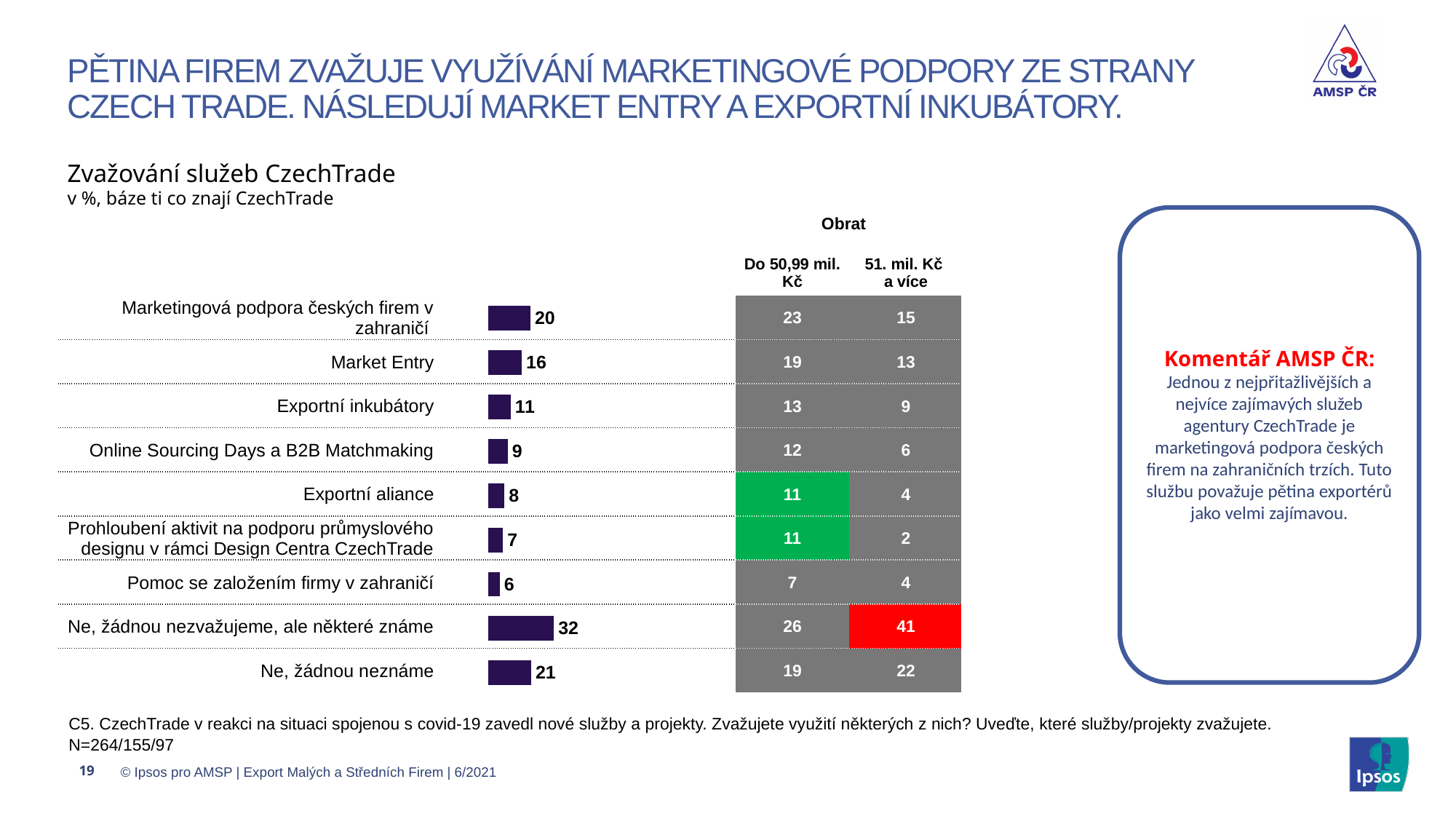
What is the value for "Exportní inkubátory" in the bar chart? 11 What is the value for "Pomoc se založením firmy v zahraničí" in the bar chart? 6 What type of chart is shown on the slide? bar chart What is the difference between the values for "Online Sourcing Days a B2B Matchmaking" and "Exportní aliance"? 1 Which is larger: the value for "Marketingová podpora českých firem v zahraničí" or the value for "Market Entry"? Marketingová podpora českých firem v zahraničí How many categories does the bar chart show? 9 Which category has the highest value in the bar chart? Ne, žádnou nezvažujeme, ale některé známe What is the difference between the values for "Ne, žádnou nezvažujeme, ale některé známe" and "Ne, žádnou neznáme"? 11 Which category has the lowest value in the bar chart? Pomoc se založením firmy v zahraničí What is the value for "Market Entry" in the bar chart? 16 What is the title of the chart? Zvažování služeb CzechTrade In the table next to the chart, what is the value for "Ne, žádnou nezvažujeme, ale některé známe" in the "51. mil. Kč a více" column? 41